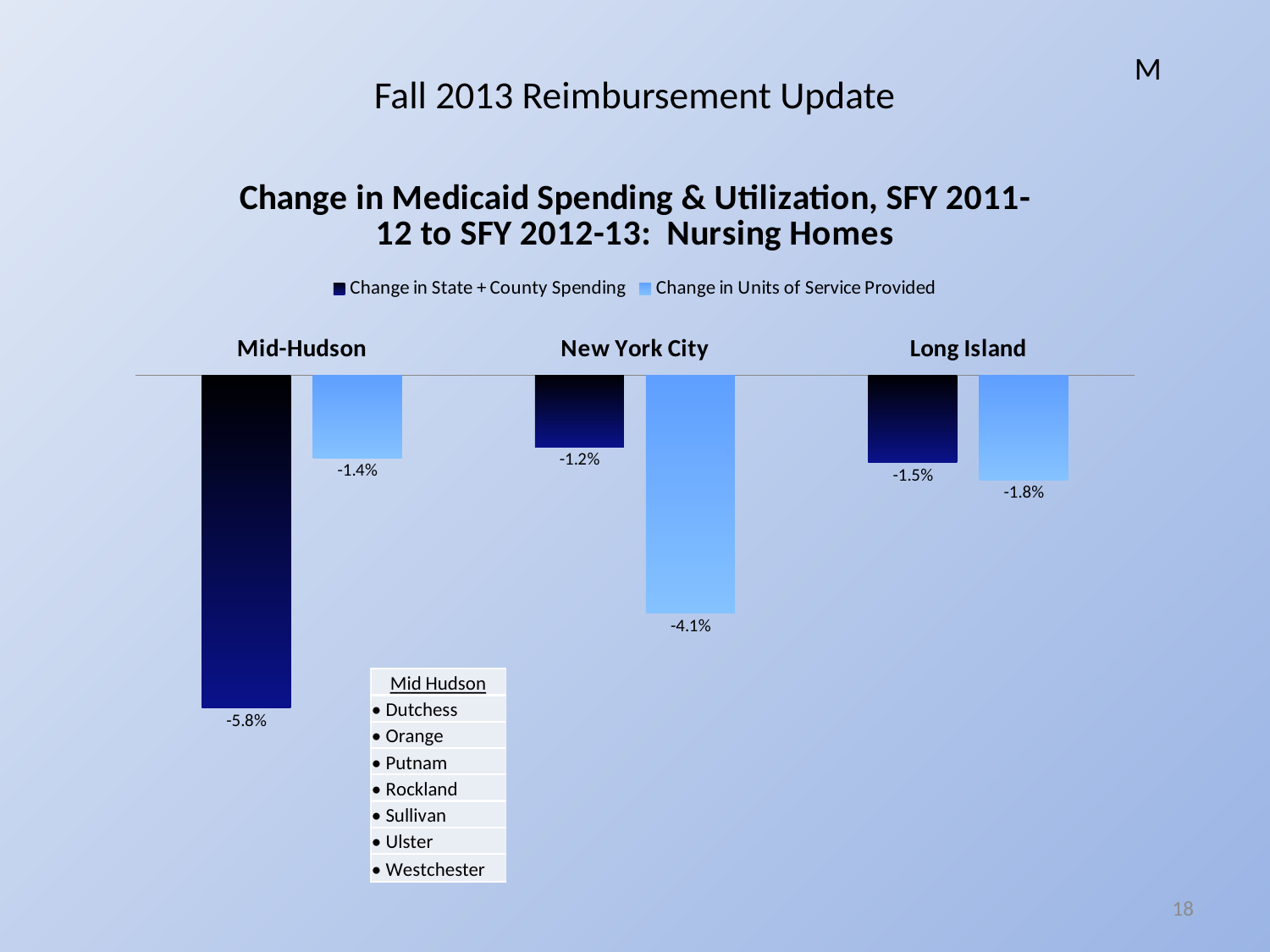
What is the Change in Units of Service Provided for New York City? -4.1% What is the Change in Units of Service Provided for Long Island? -1.8% Which region has the lowest Change in Units of Service Provided? New York City What is the Change in State + County Spending for Long Island? -1.5% How many regions are shown on the chart? 3 Which region has the lowest Change in State + County Spending? Mid-Hudson How many series does the legend list? 2 For New York City, which is larger: the Change in State + County Spending or the Change in Units of Service Provided? Change in State + County Spending What is the difference between the Change in State + County Spending and the Change in Units of Service Provided for Mid-Hudson? 4.4 percentage points What kind of chart is shown on the slide? Bar chart Which region has the highest Change in State + County Spending? New York City What is the Change in State + County Spending for Mid-Hudson? -5.8%